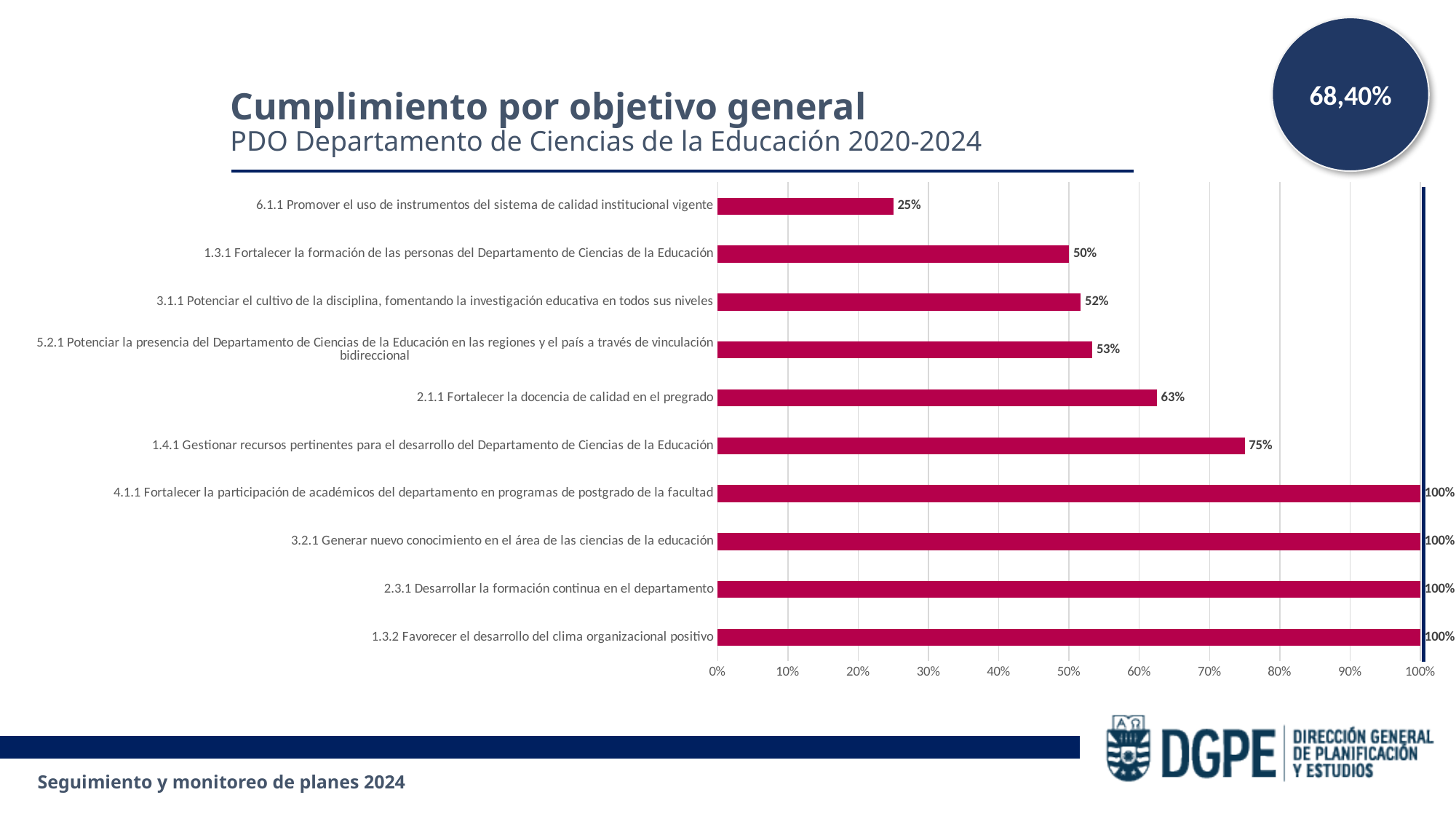
How many objectives have a value of 100%? 4 What is the value for 5.2.1 Potenciar la presencia del Departamento de Ciencias de la Educación en las regiones y el país a través de vinculación bidireccional? 53% Is the value for 1.3.1 Fortalecer la formación de las personas greater or less than 60%? less What kind of chart is shown on the slide? Bar chart What is the value for 6.1.1 Promover el uso de instrumentos del sistema de calidad institucional vigente? 25% Which objective has the lowest value? 6.1.1 Promover el uso de instrumentos del sistema de calidad institucional vigente What is the value for 1.4.1 Gestionar recursos pertinentes para el desarrollo del Departamento de Ciencias de la Educación? 75% Which is larger, the value for 3.1.1 Potenciar el cultivo de la disciplina or the value for 2.1.1 Fortalecer la docencia de calidad en el pregrado? 2.1.1 Fortalecer la docencia de calidad en el pregrado How many objectives are shown in the chart? 10 What is the value for 2.1.1 Fortalecer la docencia de calidad en el pregrado? 63% What is the title of the chart? Cumplimiento por objetivo general What is the difference between the values for 1.4.1 Gestionar recursos pertinentes and 1.3.1 Fortalecer la formación de las personas? 25%